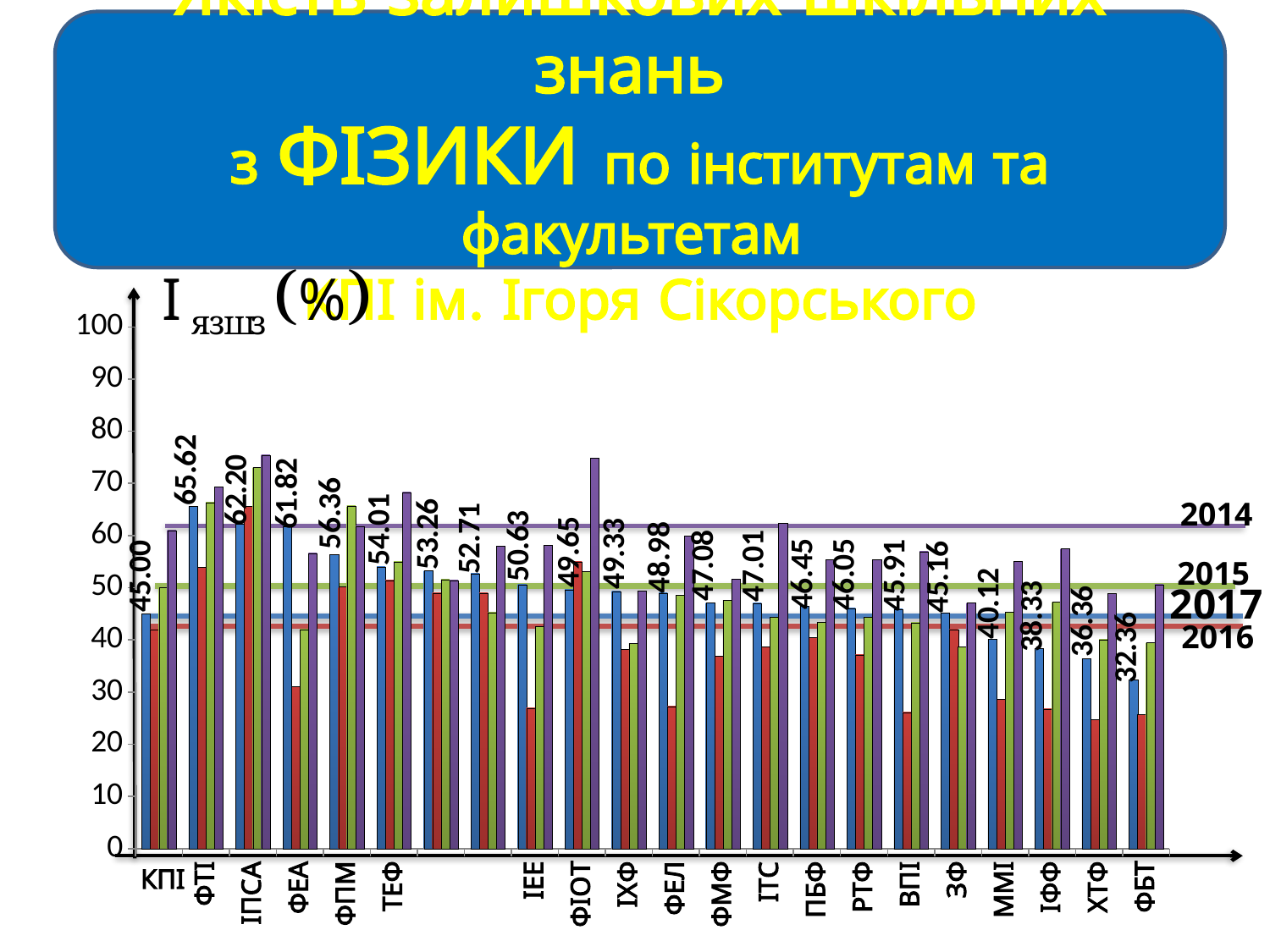
What is the data label shown for КПІ? 45.00 Which category has the highest data label value? ФП What is the data label shown for ФП? 65.62 What is the data label shown for ФБТ? 32.36 What kind of chart is shown on the slide? bar chart Which has the larger labeled value, ФПМ or ТЕФ? ФПМ Is the tallest bar for ФІОТ greater or less than 70? greater Going from ФП to ФБТ along the x axis, do the labeled values rise or fall? fall Which year's horizontal reference line is the highest on the chart? 2014 What is the difference between the labeled values for ФП and ФБТ? 33.26 Which category has the lowest data label value? ФБТ What is the data label shown for ММІ? 40.12